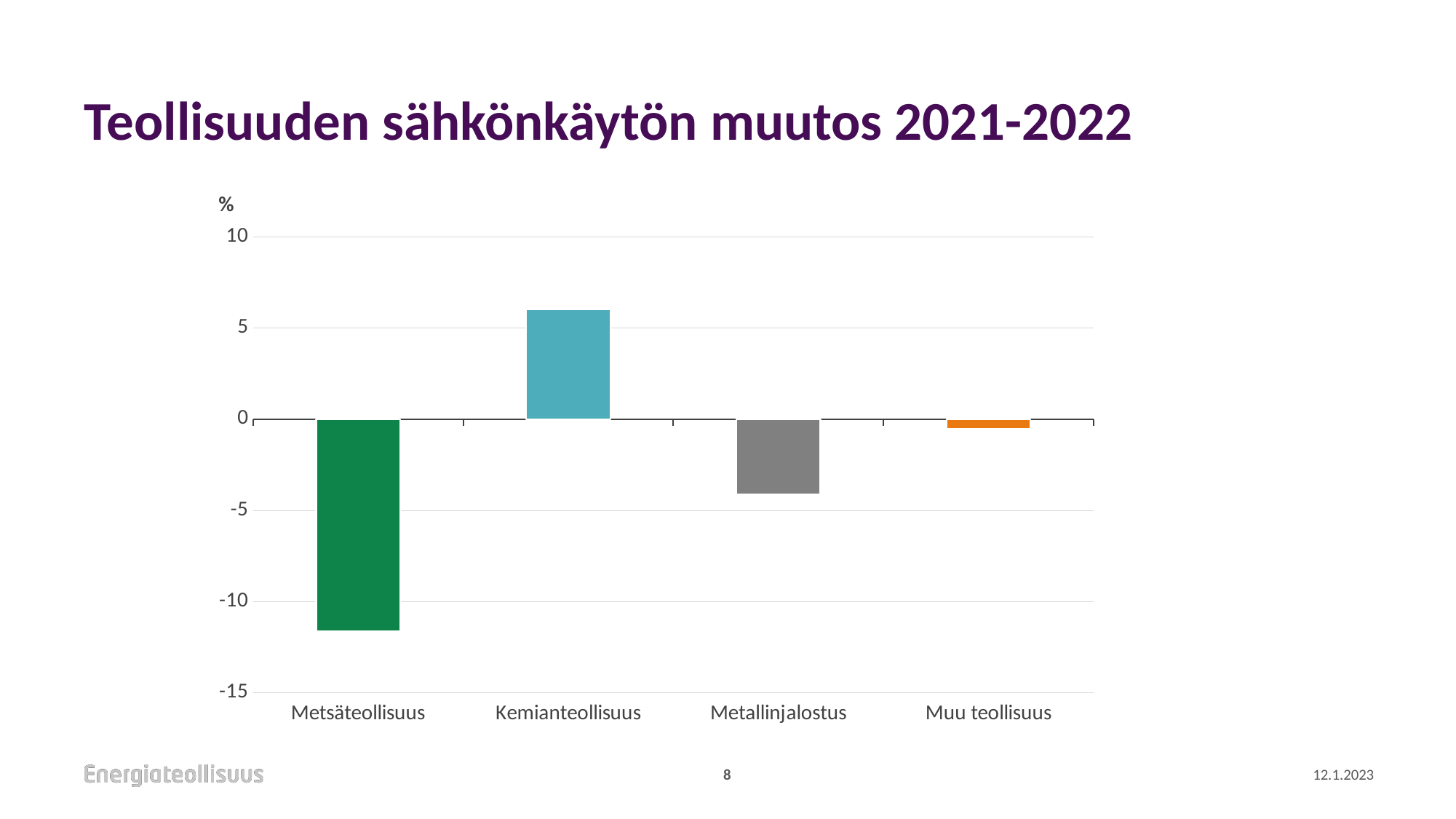
Is the value for Metallinjalostus greater or less than -5? greater Is the value for Kemianteollisuus greater or less than 5? greater What is the title of the chart on the slide? Teollisuuden sähkönkäytön muutos 2021-2022 Which category has the lowest value in the chart? Metsäteollisuus How many categories are shown on the x axis of the chart? 4 What unit is shown at the top of the y axis of the chart? % Which category has the highest value in the chart? Kemianteollisuus Which is larger, the value for Kemianteollisuus or the value for Muu teollisuus? Kemianteollisuus Is the value for Muu teollisuus greater or less than 0? less What kind of chart is shown on the slide? bar chart Which is larger, the value for Metallinjalostus or the value for Metsäteollisuus? Metallinjalostus